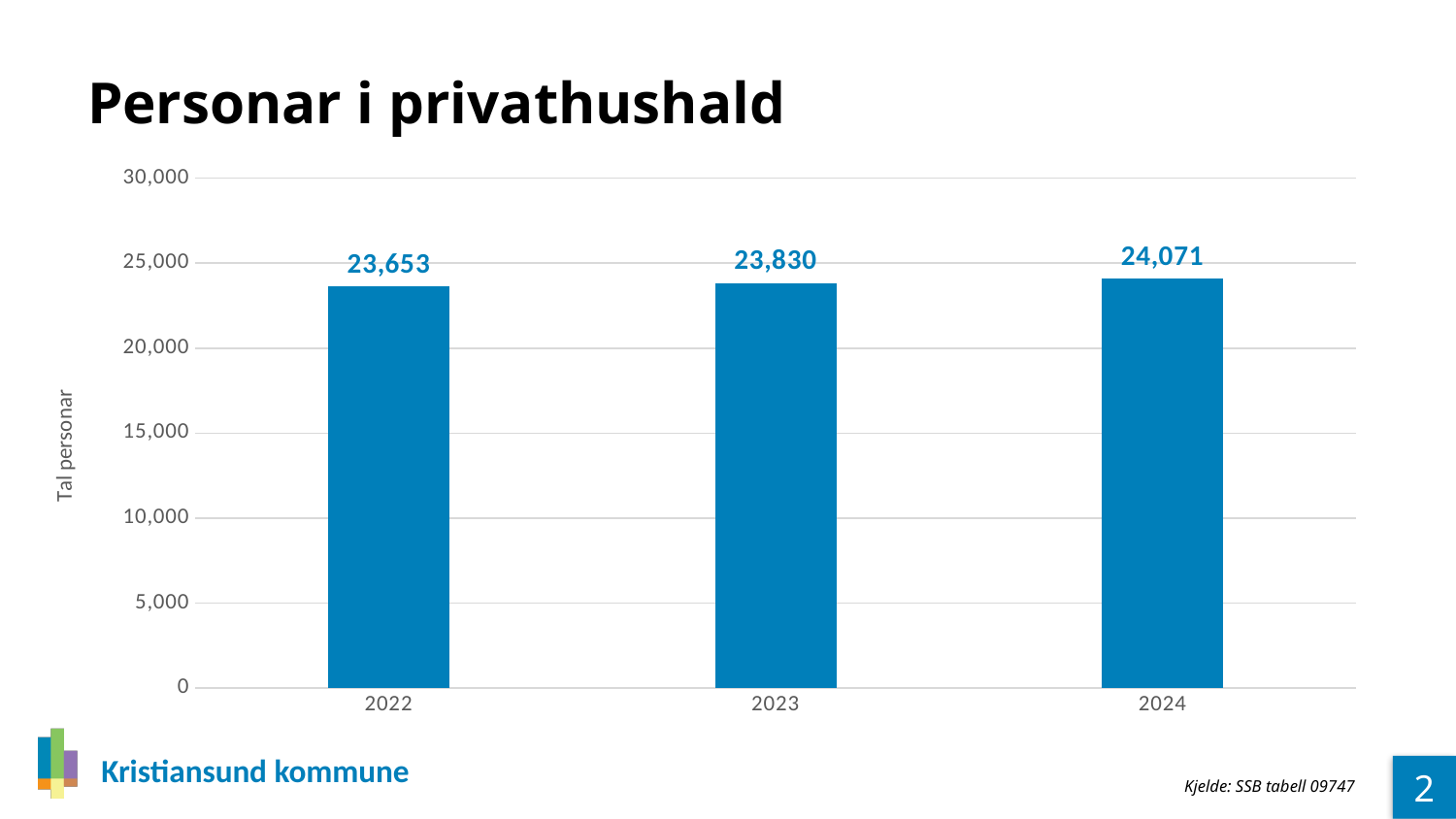
Do the values rise or fall from 2022 to 2024? rise What is the difference between the values for 2023 and 2022? 177 How many years are shown on the x axis? 3 What is the value for 2023? 23,830 Is the value for 2022 greater or less than 25,000? less Which year has the lowest value? 2022 What is the value for 2024? 24,071 What is the value for 2022? 23,653 What kind of chart is shown on the slide? bar chart What is the difference between the values for 2024 and 2022? 418 Which year has the highest value? 2024 Which is larger, the value for 2023 or the value for 2024? 2024